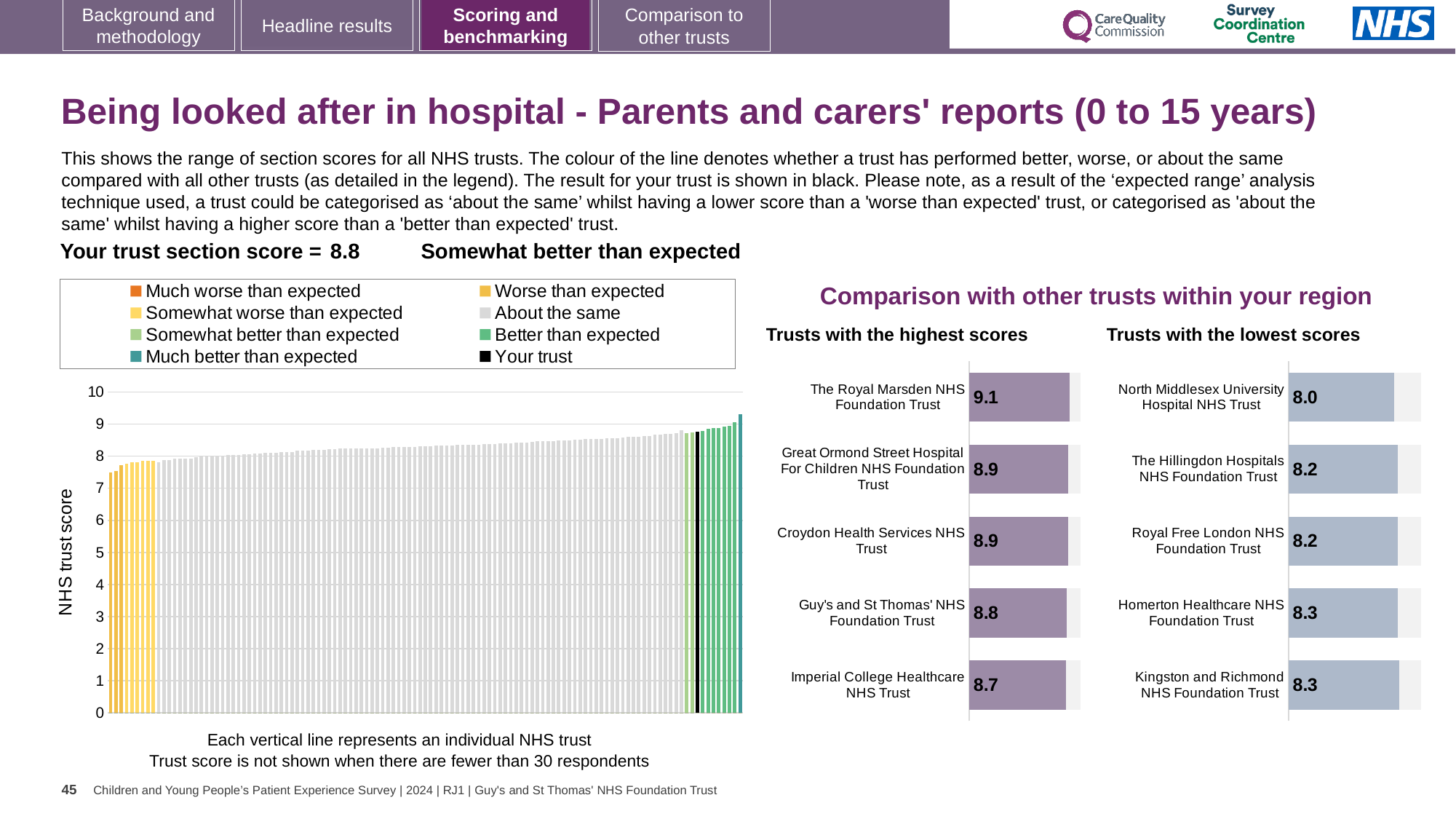
In the 'Trusts with the lowest scores' chart, which has the higher score: Homerton Healthcare NHS Foundation Trust or The Hillingdon Hospitals NHS Foundation Trust? Homerton Healthcare NHS Foundation Trust What kind of chart is the large 'NHS trust score' chart on the left of the slide? Bar chart How many trusts are shown in the 'Trusts with the highest scores' chart? 5 In the 'Trusts with the highest scores' chart, what is the difference between the scores of The Royal Marsden NHS Foundation Trust and Imperial College Healthcare NHS Trust? 0.4 How many entries does the legend above the large 'NHS trust score' chart list? 8 In the 'Trusts with the highest scores' chart, what is the score for The Royal Marsden NHS Foundation Trust? 9.1 In the 'Trusts with the lowest scores' chart, which trust has the lowest score? North Middlesex University Hospital NHS Trust What is your trust's section score shown on the slide? 8.8 In the 'Trusts with the highest scores' chart, which trust has the highest score? The Royal Marsden NHS Foundation Trust In the large 'NHS trust score' chart on the left, do the bar values rise or fall from left to right? Rise In the 'Trusts with the lowest scores' chart, what is the difference between the scores of Kingston and Richmond NHS Foundation Trust and North Middlesex University Hospital NHS Trust? 0.3 In the 'Trusts with the lowest scores' chart, what is the score for North Middlesex University Hospital NHS Trust? 8.0